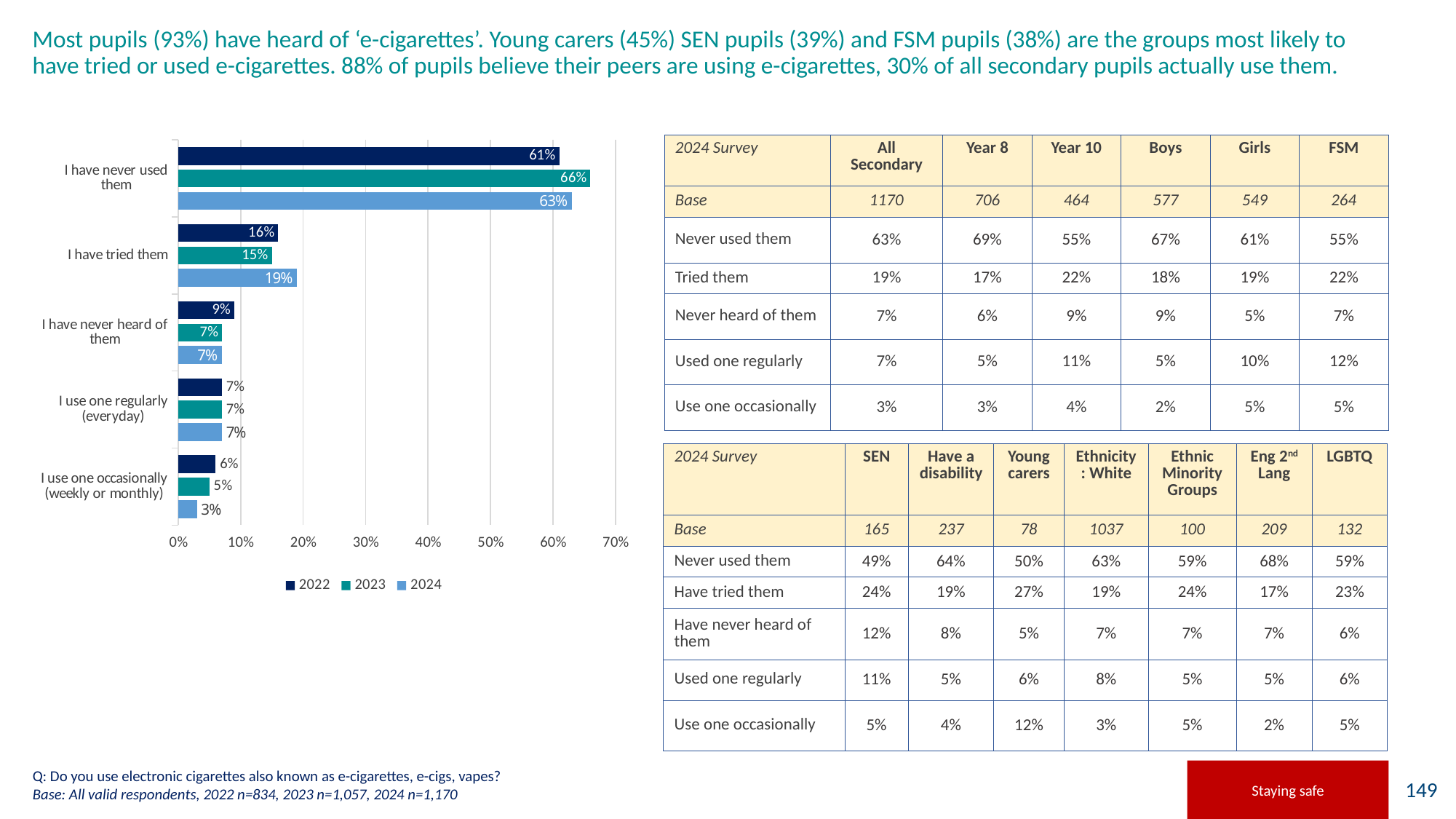
How many categories are shown on the chart? 5 Which is larger for 'I have tried them': the 2022 value or the 2023 value? 2022 Which series is shown in the darkest blue colour in the legend? 2022 What is the 2022 value for 'I have never heard of them'? 9% What is the 2024 value for 'I use one occasionally (weekly or monthly)'? 3% What is the 2023 value for 'I have never used them'? 66% Which category has the lowest value for the 2024 series? I use one occasionally (weekly or monthly) What is the 2024 value for 'I have tried them'? 19% Which category has the highest value for the 2024 series? I have never used them What is the difference between the 2023 and 2022 values for 'I have never used them'? 5% How many series does the chart legend list? 3 What kind of chart is shown on the slide? bar chart